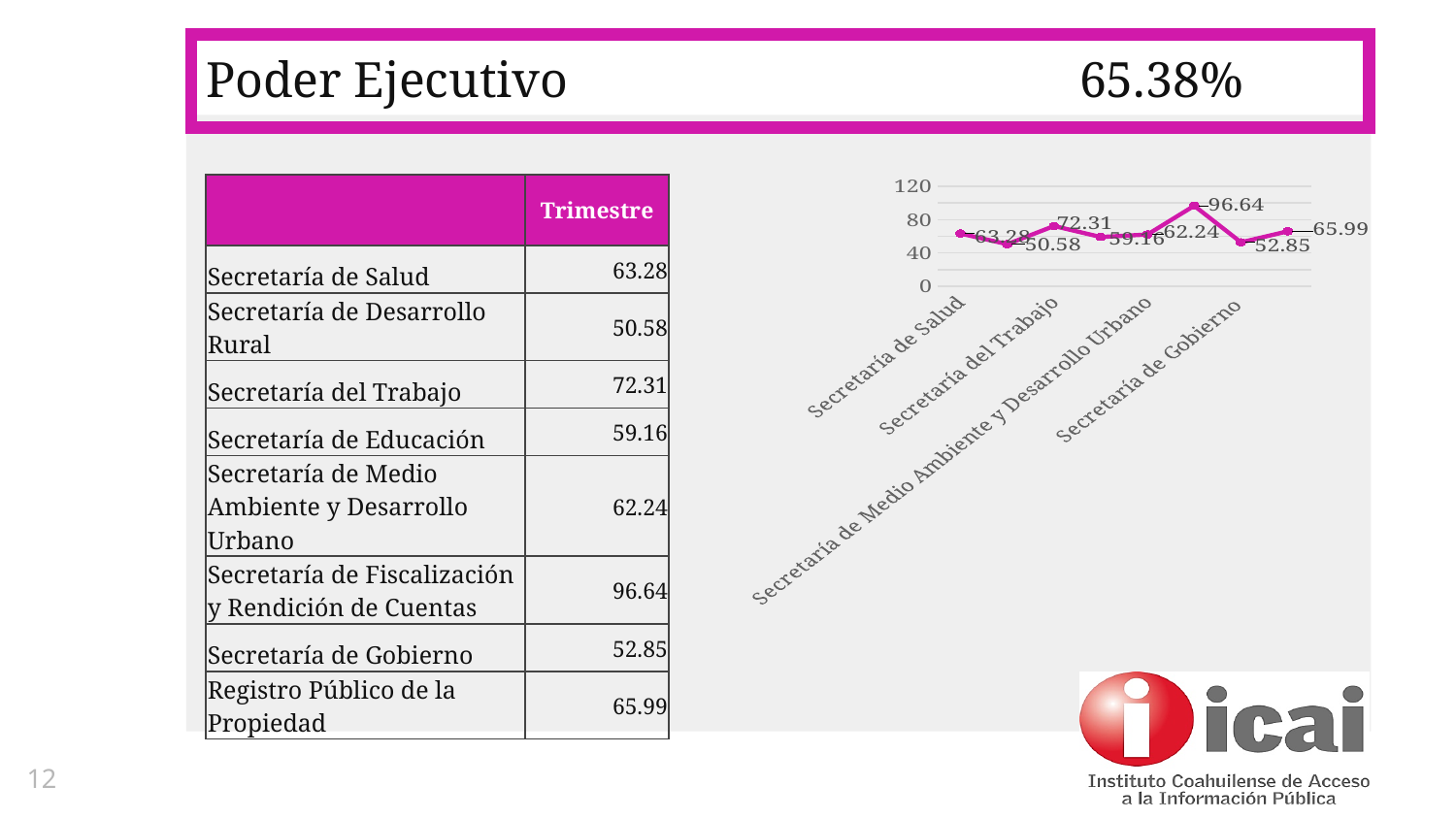
Which category has the lowest value in the chart? Secretaría de Desarrollo Rural What is the value for Secretaría de Gobierno in the chart? 52.85 What is the value for Secretaría de Medio Ambiente y Desarrollo Urbano in the chart? 62.24 Is the value for Secretaría de Fiscalización y Rendición de Cuentas greater or less than 80? greater Which is larger, the value for Secretaría de Gobierno or the value for Secretaría de Medio Ambiente y Desarrollo Urbano? Secretaría de Medio Ambiente y Desarrollo Urbano Which category has the highest value in the chart? Secretaría de Fiscalización y Rendición de Cuentas How many data points are plotted in the chart? 8 What is the value for Secretaría del Trabajo in the chart? 72.31 What is the value for Secretaría de Salud in the chart? 63.28 What is the difference between the values for Secretaría del Trabajo and Secretaría de Salud? 9.03 What is the highest value shown on the chart's vertical axis? 120 What type of chart is shown on the slide? line chart